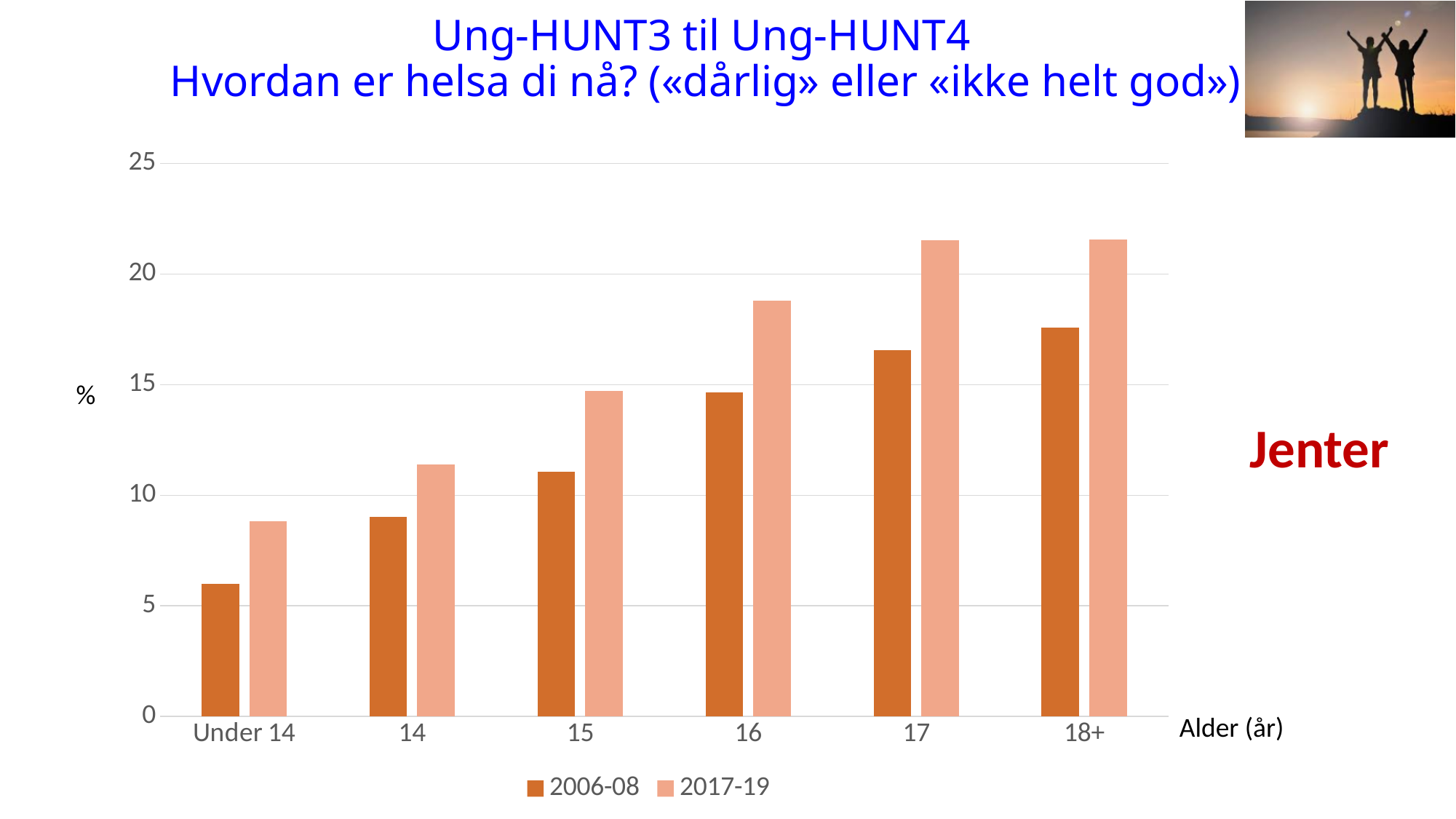
Which age category has the highest value for the 2006-08 series? 18+ Is the value for 16 in the 2017-19 series greater or less than 20? less Which age category has the lowest value for the 2006-08 series? Under 14 Which age category has the lowest value for the 2017-19 series? Under 14 Is the value for Under 14 in the 2006-08 series greater or less than 5? greater Do the values for the 2017-19 series generally rise or fall as age increases along the x axis? rise How many age categories are shown on the x axis? 6 For age 16, which series has the larger value, 2006-08 or 2017-19? 2017-19 Is the value for 18+ in the 2006-08 series greater or less than 20? less What kind of chart is shown on the slide? bar chart How many series does the legend list? 2